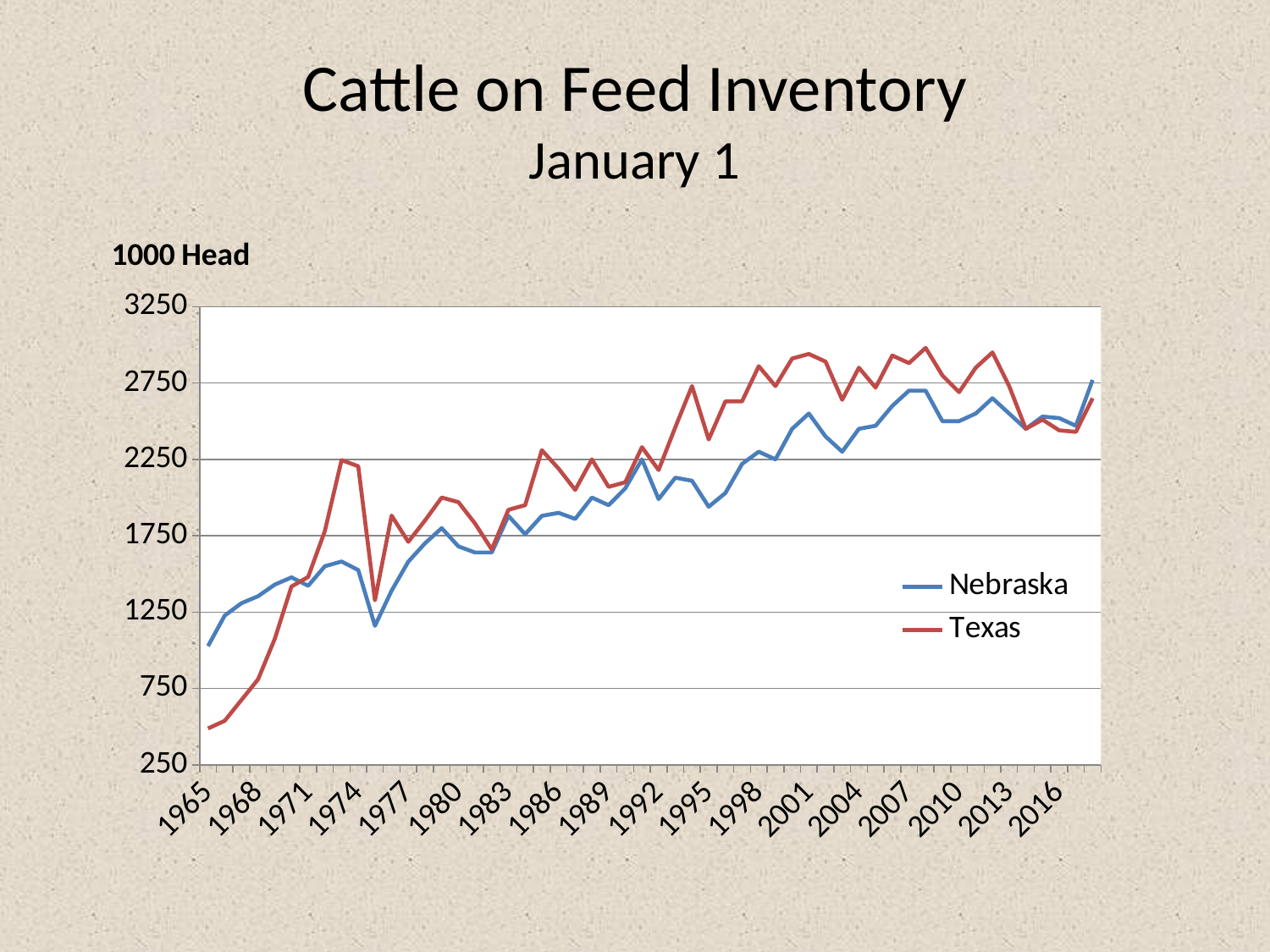
In 1965, which series has the larger value, Nebraska or Texas? Nebraska In 2007, which series has the larger value, Nebraska or Texas? Texas Is the value for Texas in 2007 greater or less than 2750? greater Which series reaches the highest value on the chart? Texas Is the value for Texas in 1965 greater or less than 750? less Does the Texas line rise or fall between 1965 and 1974? rise What unit is shown above the vertical axis? 1000 Head Is the value for Nebraska in 1965 greater or less than 1250? less How many series does the legend list? 2 What kind of chart is shown on the slide? line chart What is the title of the chart? Cattle on Feed Inventory January 1